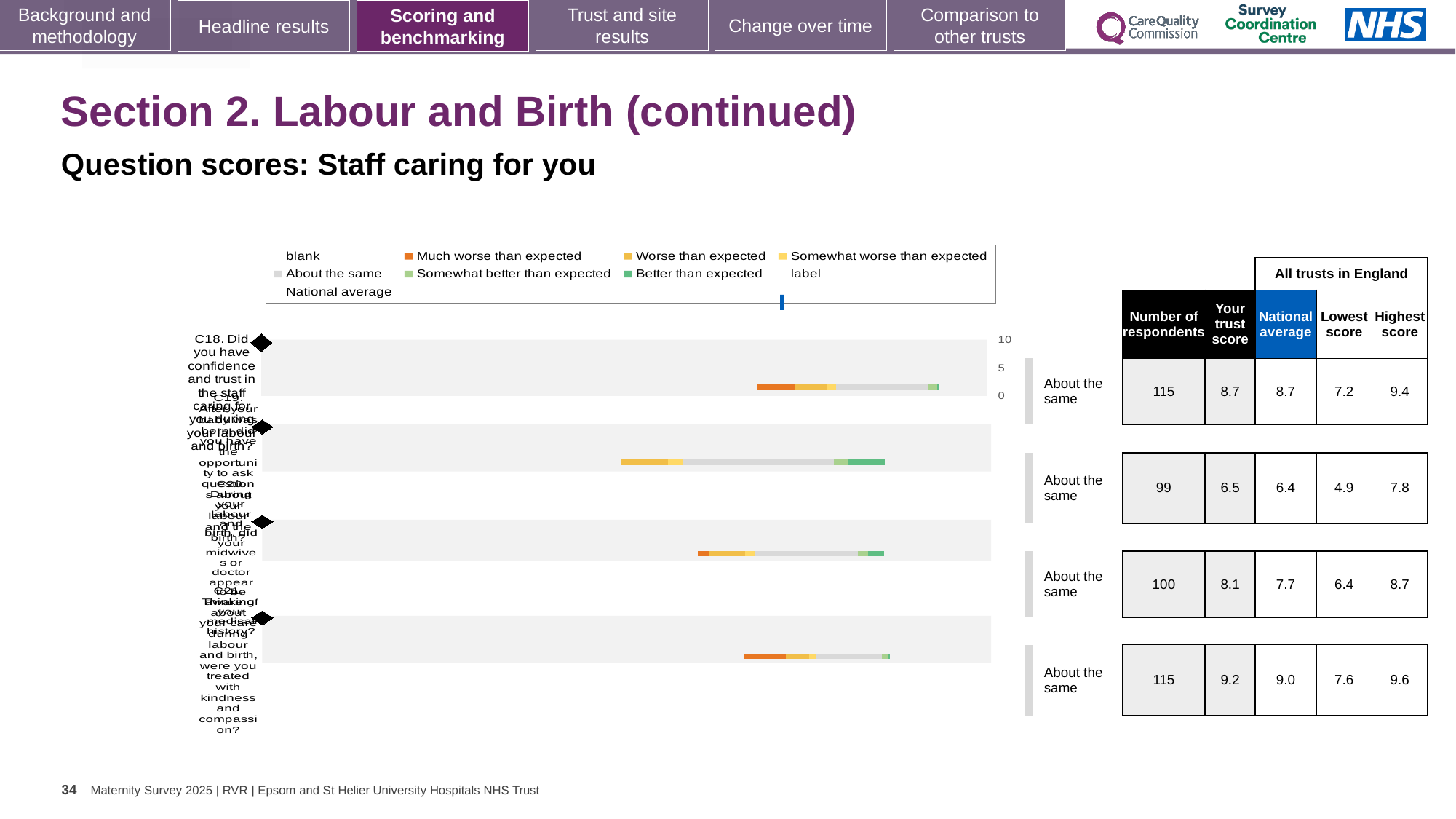
In the table, what is the number of respondents for the second row? 99 How many question rows are plotted in the chart? 4 Which row has the highest 'Your trust score' in the table? the fourth row (9.2) What kind of chart is shown on the slide? bar chart In the table, what is the national average for the third row? 7.7 What is the lowest score across all trusts in England for the second row? 4.9 For the third row, which is larger: the trust score or the national average? the trust score (8.1) What benchmark category is shown next to each of the four rows? About the same What is the difference between the highest 'Your trust score' (9.2) and the lowest (6.5) in the table? 2.7 In the table, what is the highest score across all trusts in England for the fourth row? 9.6 In the table, what is the 'Your trust score' for the first row (C18, confidence and trust in the staff caring for you)? 8.7 Which row has the lowest 'Your trust score' in the table? the second row (6.5)